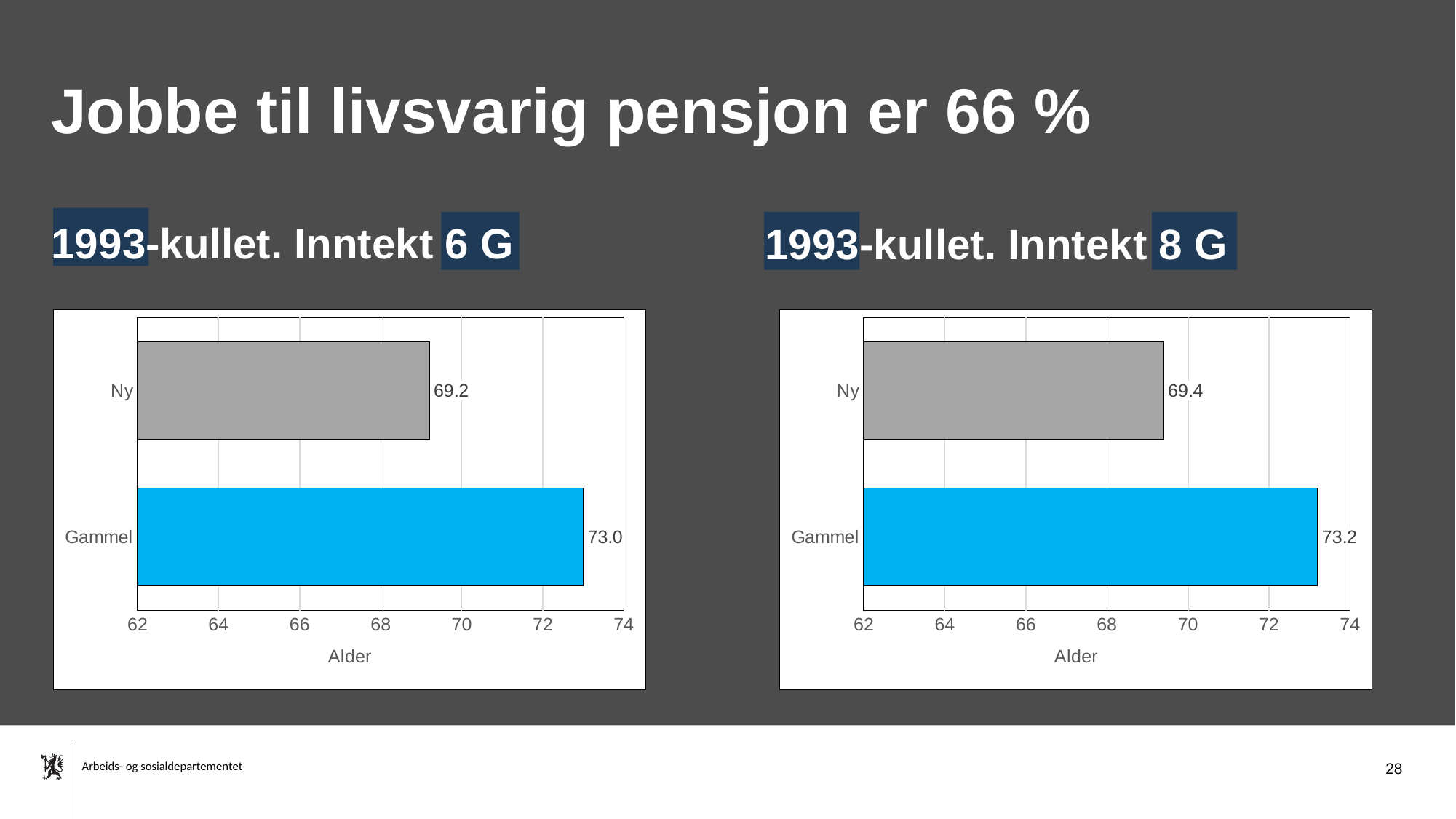
In the '1993-kullet. Inntekt 8 G' chart, what is the difference between the values for Gammel and Ny? 3.8 How many categories are shown in the '1993-kullet. Inntekt 6 G' chart? 2 In the '1993-kullet. Inntekt 8 G' chart, which is larger, the value for Ny or the value for Gammel? Gammel What kind of chart is the '1993-kullet. Inntekt 8 G' chart? bar chart In the '1993-kullet. Inntekt 8 G' chart, what is the value for Ny? 69.4 In the '1993-kullet. Inntekt 8 G' chart, what is the value for Gammel? 73.2 In the '1993-kullet. Inntekt 6 G' chart, which category has the highest value? Gammel In the '1993-kullet. Inntekt 8 G' chart, which category has the lowest value? Ny In the '1993-kullet. Inntekt 6 G' chart, what is the difference between the values for Gammel and Ny? 3.8 In the '1993-kullet. Inntekt 6 G' chart, what is the value for Gammel? 73.0 In the '1993-kullet. Inntekt 6 G' chart, what is the value for Ny? 69.2 In the '1993-kullet. Inntekt 6 G' chart, is the value for Ny greater or less than 70? less